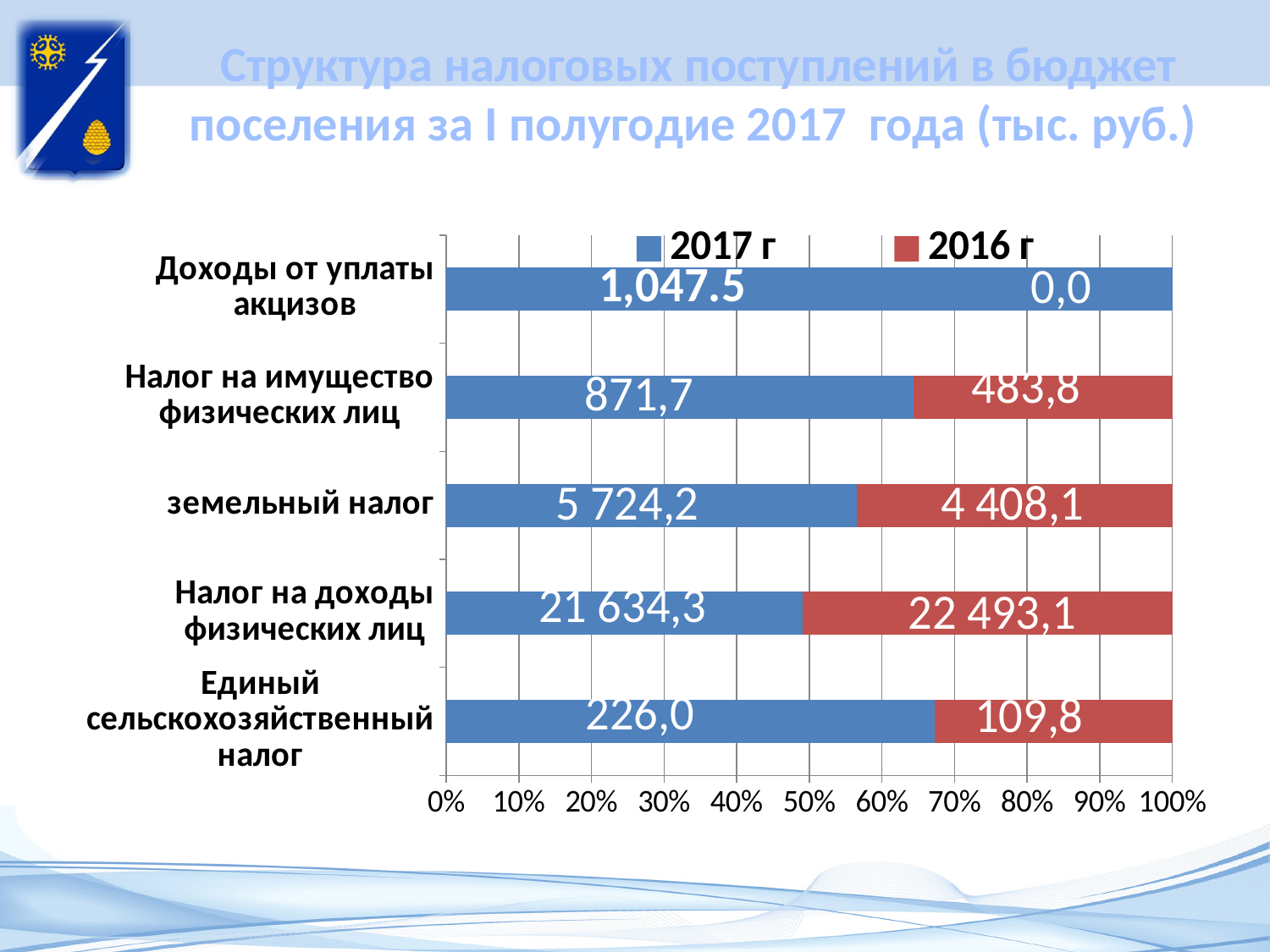
What kind of chart is shown on the slide? Stacked bar chart What is the 2017 г value for Доходы от уплаты акцизов? 1,047.5 Which category has the lowest 2016 г value? Доходы от уплаты акцизов Which category has the highest 2017 г value? Налог на доходы физических лиц For Налог на доходы физических лиц, which is larger: the 2017 г value or the 2016 г value? 2016 г What is the difference between the 2017 г and 2016 г values for Налог на имущество физических лиц? 387,9 What is the 2016 г value for Единый сельскохозяйственный налог? 109,8 What is the difference between the 2017 г and 2016 г values for земельный налог? 1 316,1 How many series does the legend list? 2 How many categories are shown on the chart? 5 What is the 2016 г value for Налог на доходы физических лиц? 22 493,1 What is the 2017 г value for земельный налог? 5 724,2